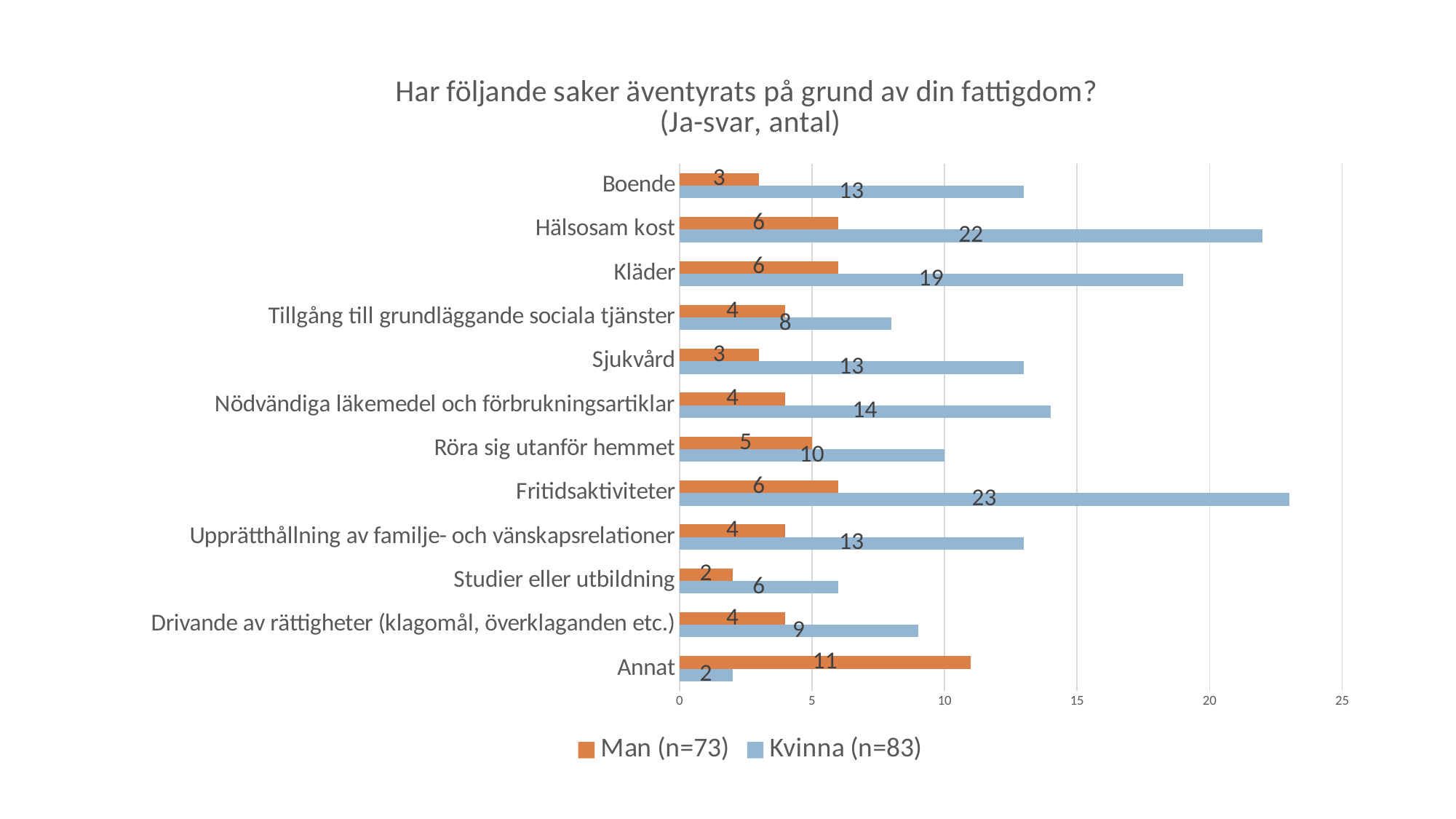
What is the value for Man (n=73) for Annat? 11 What is the value for Kvinna (n=83) for Hälsosam kost? 22 How many series does the legend list? 2 What is the value for Kvinna (n=83) for Studier eller utbildning? 6 Which category has the lowest value for Man (n=73)? Studier eller utbildning What is the difference between the Kvinna (n=83) and Man (n=73) values for Kläder? 13 Is the value for Kvinna (n=83) for Fritidsaktiviteter greater or less than 20? greater What kind of chart is shown on the slide? bar chart Which category has the highest value for Kvinna (n=83)? Fritidsaktiviteter What colour are the bars for Man (n=73)? orange For Annat, which series has the larger value, Man (n=73) or Kvinna (n=83)? Man (n=73) How many categories are shown on the chart? 12